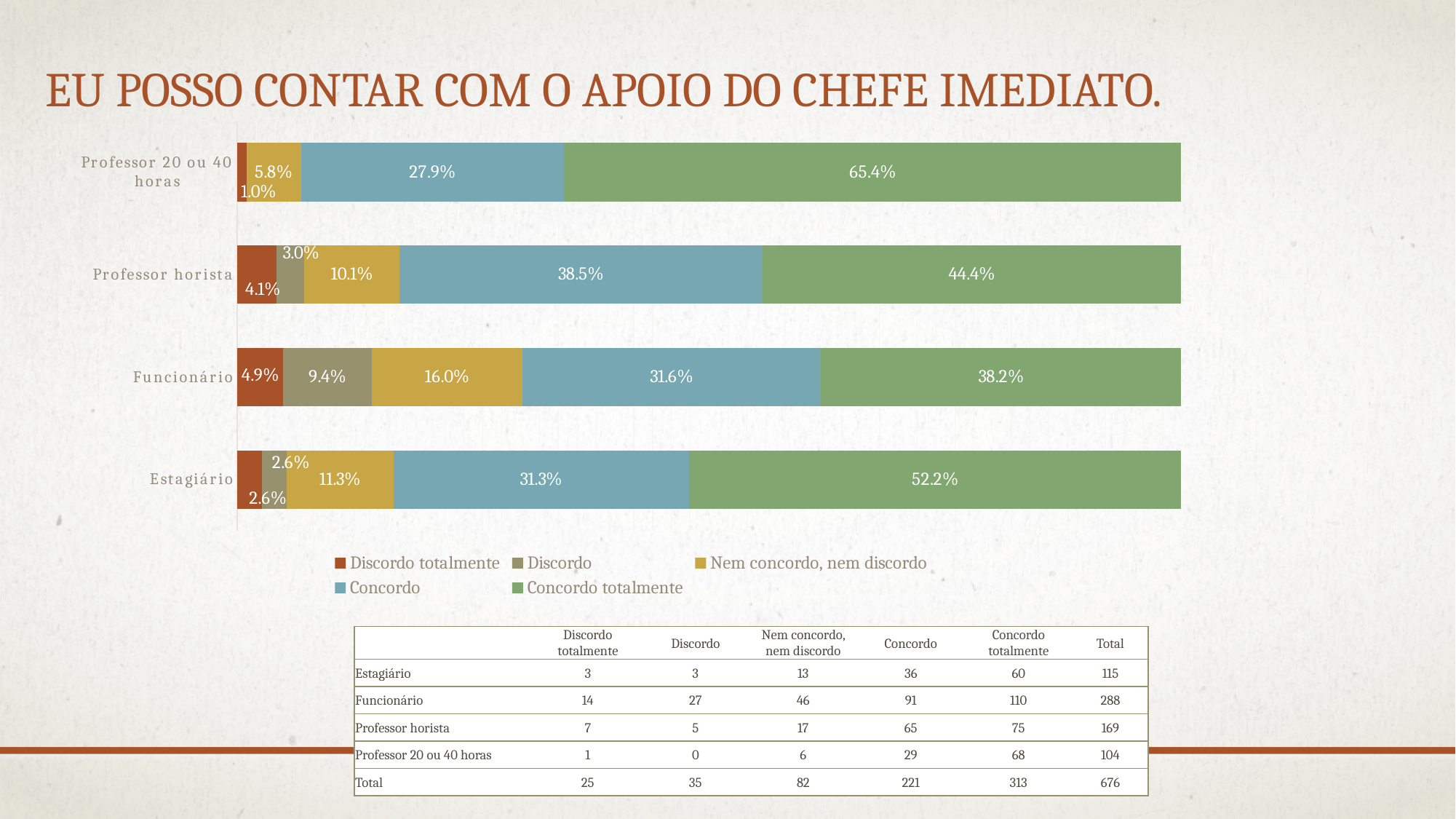
How many series does the legend list? 5 What is the title of the slide? EU POSSO CONTAR COM O APOIO DO CHEFE IMEDIATO. What is the 'Concordo' value for Professor horista? 38.5% What kind of chart is shown on the slide? Stacked bar chart How many categories are shown on the chart? 4 What is the difference between the 'Concordo totalmente' values for Professor 20 ou 40 horas and Professor horista? 21.0 percentage points Which category has the lowest 'Concordo totalmente' value? Funcionário What is the 'Discordo totalmente' value for Estagiário? 2.6% Which is larger: the 'Concordo' value for Funcionário or for Estagiário? Funcionário What is the 'Concordo totalmente' value for Professor 20 ou 40 horas? 65.4% What is the 'Nem concordo, nem discordo' value for Funcionário? 16.0% Which category has the highest 'Concordo totalmente' value? Professor 20 ou 40 horas